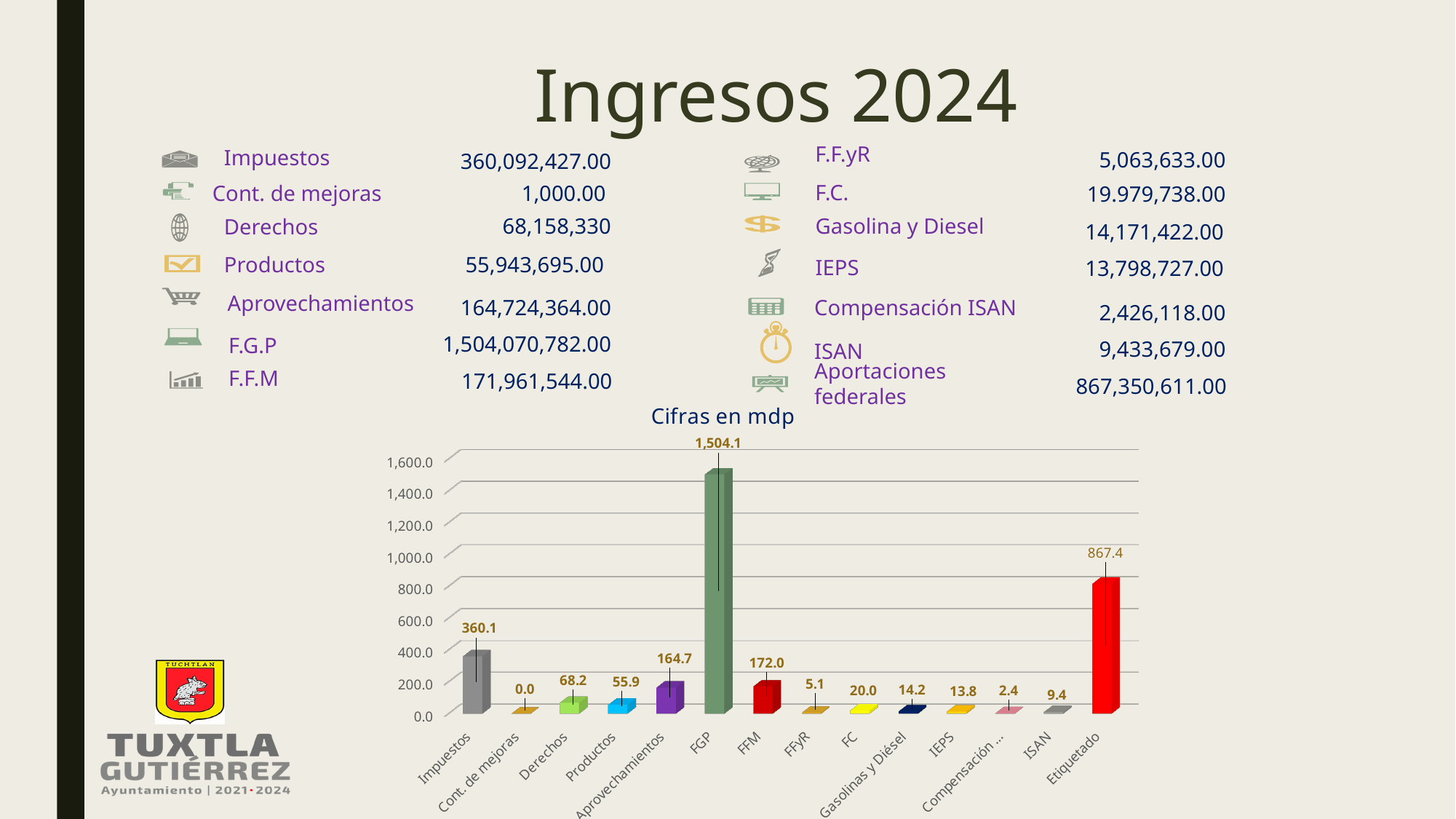
What is the value for IEPS in the chart? 13.8 How many categories are shown on the x axis of the chart? 14 What is the difference between the values for FGP and Etiquetado? 636.7 What is the title of the chart? Cifras en mdp Which category has the lowest value in the chart? Cont. de mejoras What is the value for Aprovechamientos in the chart? 164.7 Which is larger, the value for FFM or the value for Aprovechamientos? FFM What is the value for FGP in the chart? 1,504.1 Which category has the highest value in the chart? FGP What kind of chart is shown on the slide? bar chart What is the value for Etiquetado in the chart? 867.4 Is the value for Impuestos greater or less than 400.0? less